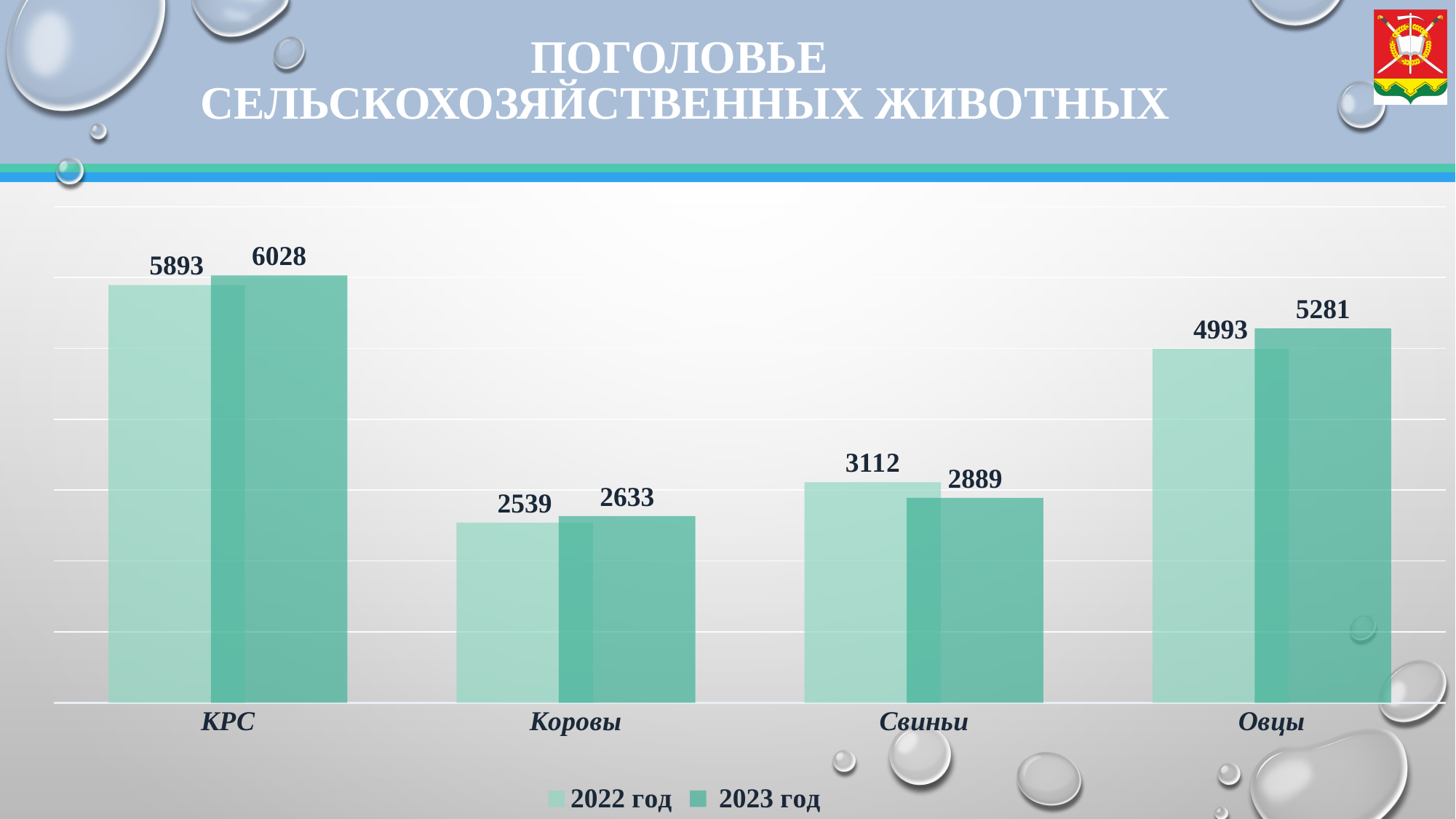
What is the value for Овцы in 2023 год? 5281 Which is larger for Овцы: the 2022 год value or the 2023 год value? 2023 год What is the difference between the 2022 год and 2023 год values for Свиньи? 223 What is the difference between the 2023 год and 2022 год values for КРС? 135 What is the value for Свиньи in 2022 год? 3112 What kind of chart is shown on the slide? bar chart How many categories are shown on the x axis? 4 Which category has the lowest value in 2023 год? Коровы Which category has the highest value in 2022 год? КРС What are the two series named in the legend? 2022 год and 2023 год What is the value for КРС in 2023 год? 6028 How many series does the legend list? 2